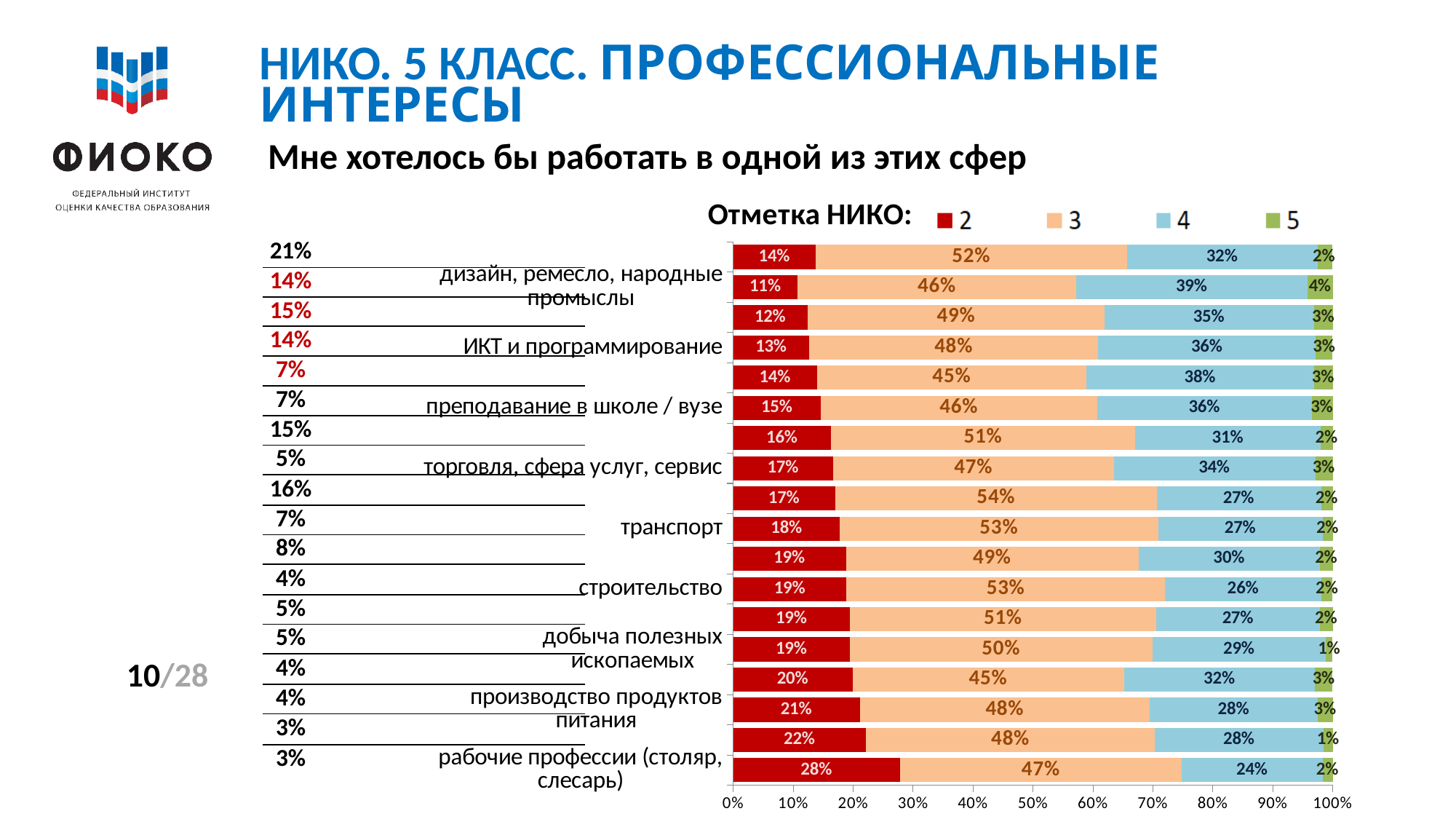
For строительство, what is the value for series 3? 53% Which is larger: the series 2 value in the top bar or the series 2 value in the bottom bar? the bottom bar What kind of chart is shown on the slide? bar chart What is the total of the top bar of the chart? 100% In the top bar of the chart, what is the value for series 3? 52% Which bar has the largest value for series 2? рабочие профессии (столяр, слесарь) What title is shown next to the chart's legend? Отметка НИКО: In the top bar, what is the difference between the value for series 3 and the value for series 4? 20% How many bars are plotted in the chart? 18 For транспорт, what is the value for series 4? 27% How many series does the legend of the chart list? 4 In the bottom bar of the chart (рабочие профессии (столяр, слесарь)), what is the value for series 2? 28%